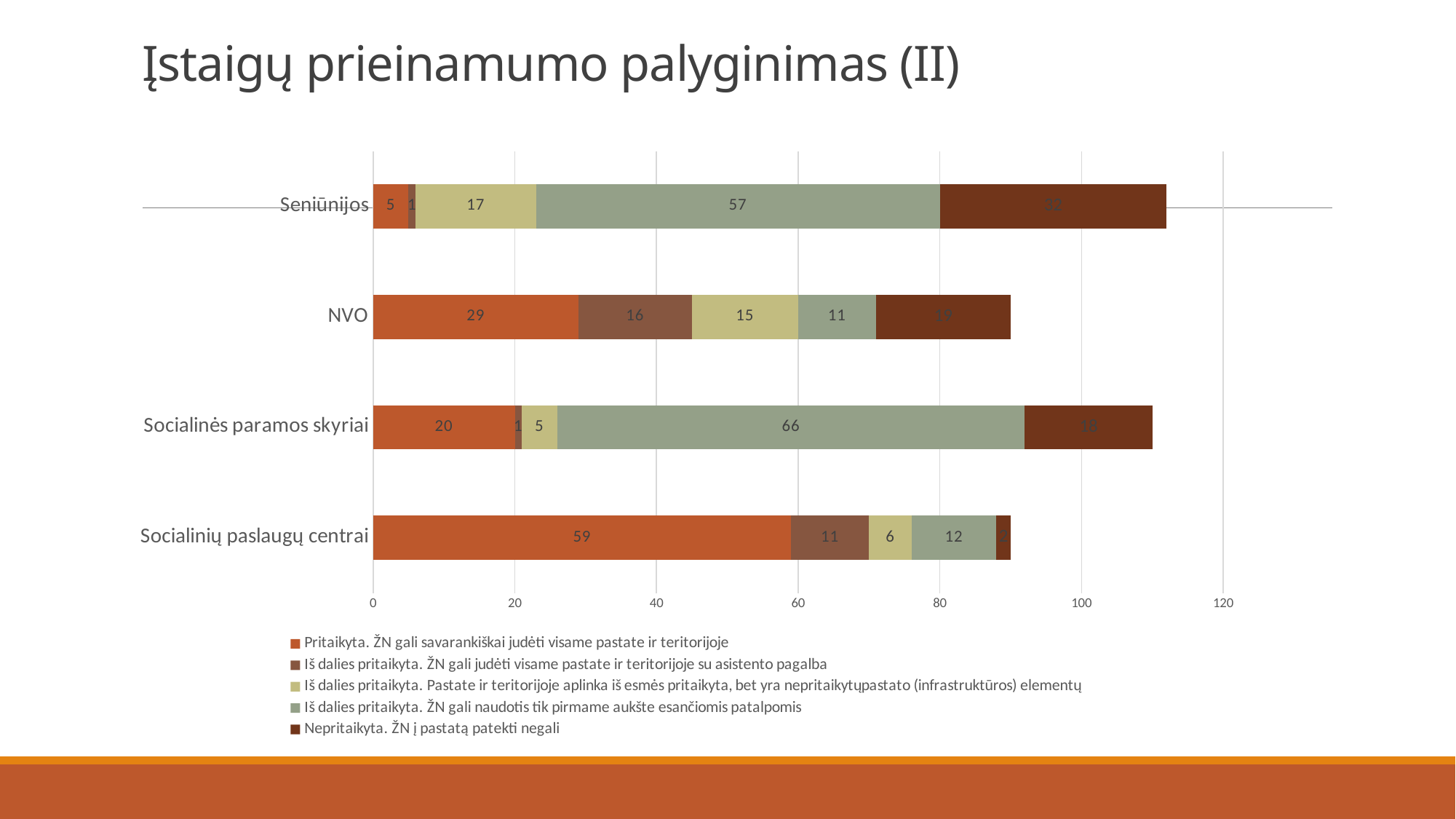
What kind of chart is shown on the slide? stacked bar chart Which category has the lowest value for 'Iš dalies pritaikyta. ŽN gali naudotis tik pirmame aukšte esančiomis patalpomis'? NVO Which is larger: the 'Pritaikyta. ŽN gali savarankiškai judėti visame pastate ir teritorijoje' value for NVO or for Socialinės paramos skyriai? NVO Which category has the highest value for 'Pritaikyta. ŽN gali savarankiškai judėti visame pastate ir teritorijoje'? Socialinių paslaugų centrai What is the value of 'Iš dalies pritaikyta. Pastate ir teritorijoje aplinka iš esmės pritaikyta, bet yra nepritaikytų pastato (infrastruktūros) elementų' for Seniūnijos? 17 How many categories (institution types) are shown on the chart? 4 What is the value of 'Iš dalies pritaikyta. ŽN gali judėti visame pastate ir teritorijoje su asistento pagalba' for NVO? 16 What is the total of the stacked bar for NVO? 90 What is the value of 'Iš dalies pritaikyta. ŽN gali naudotis tik pirmame aukšte esančiomis patalpomis' for Socialinės paramos skyriai? 66 How many series does the legend list? 5 What is the value of 'Pritaikyta. ŽN gali savarankiškai judėti visame pastate ir teritorijoje' for Socialinių paslaugų centrai? 59 What is the difference between the 'Iš dalies pritaikyta. ŽN gali naudotis tik pirmame aukšte esančiomis patalpomis' values for Socialinės paramos skyriai and Seniūnijos? 9